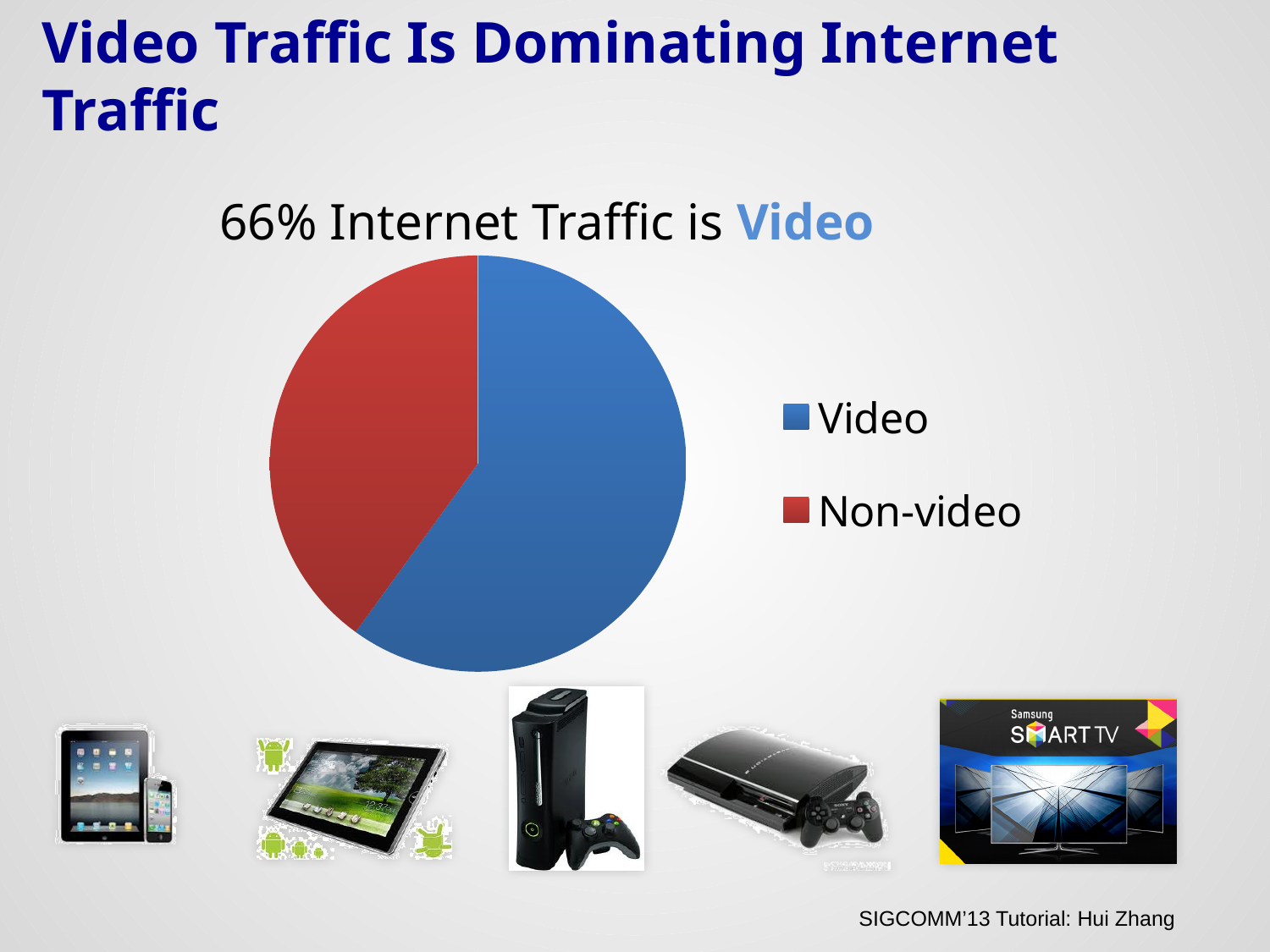
What are the two legend entries of the pie chart? Video and Non-video Which slice of the pie chart is the smallest? Non-video What kind of chart is shown on the slide? pie chart What colour is the Video slice in the pie chart? blue How many slices does the pie chart have? 2 How many entries does the legend of the pie chart list? 2 What share of Internet traffic does the Video slice represent, according to the slide? 66% Which slice of the pie chart is the largest? Video Which is larger in the pie chart, Video or Non-video? Video